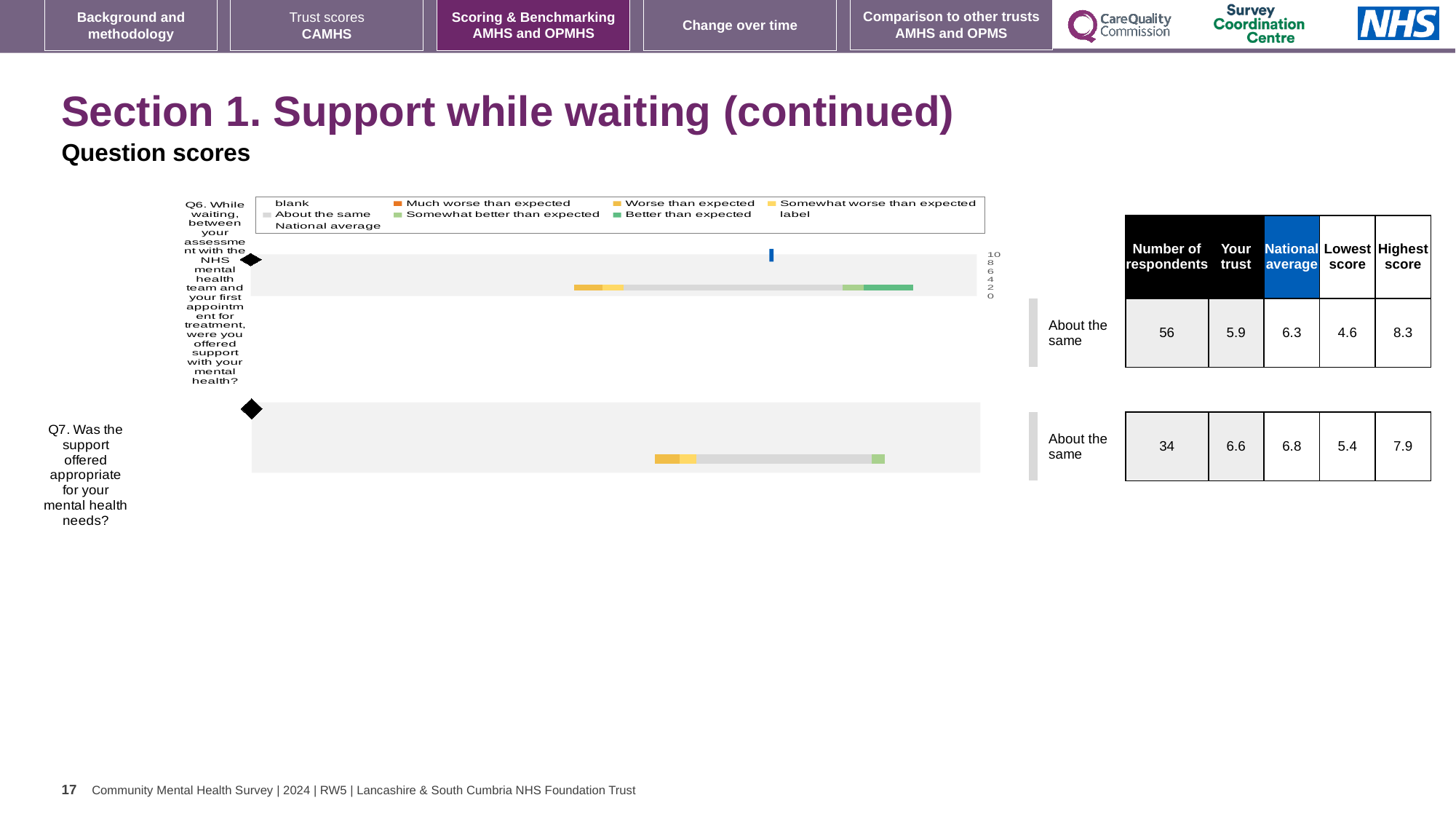
What kind of chart is used to show the question scores on this slide? Bar chart How many respondents answered Q6? 56 What is the highest score shown for Q6? 8.3 What benchmark category is the trust placed in for Q6? About the same What is the national average score for Q6? 6.3 What is the 'Your trust' score for Q6 (While waiting, between your assessment with the NHS mental health team and your first appointment for treatment, were you offered support with your mental health?)? 5.9 How many respondents answered Q7? 34 What is the national average score for Q7? 6.8 For Q6, which is larger: the 'Your trust' score or the national average? National average What is the difference between the highest score and the lowest score for Q7? 2.5 What is the 'Your trust' score for Q7 (Was the support offered appropriate for your mental health needs?)? 6.6 What is the lowest score shown for Q7? 5.4